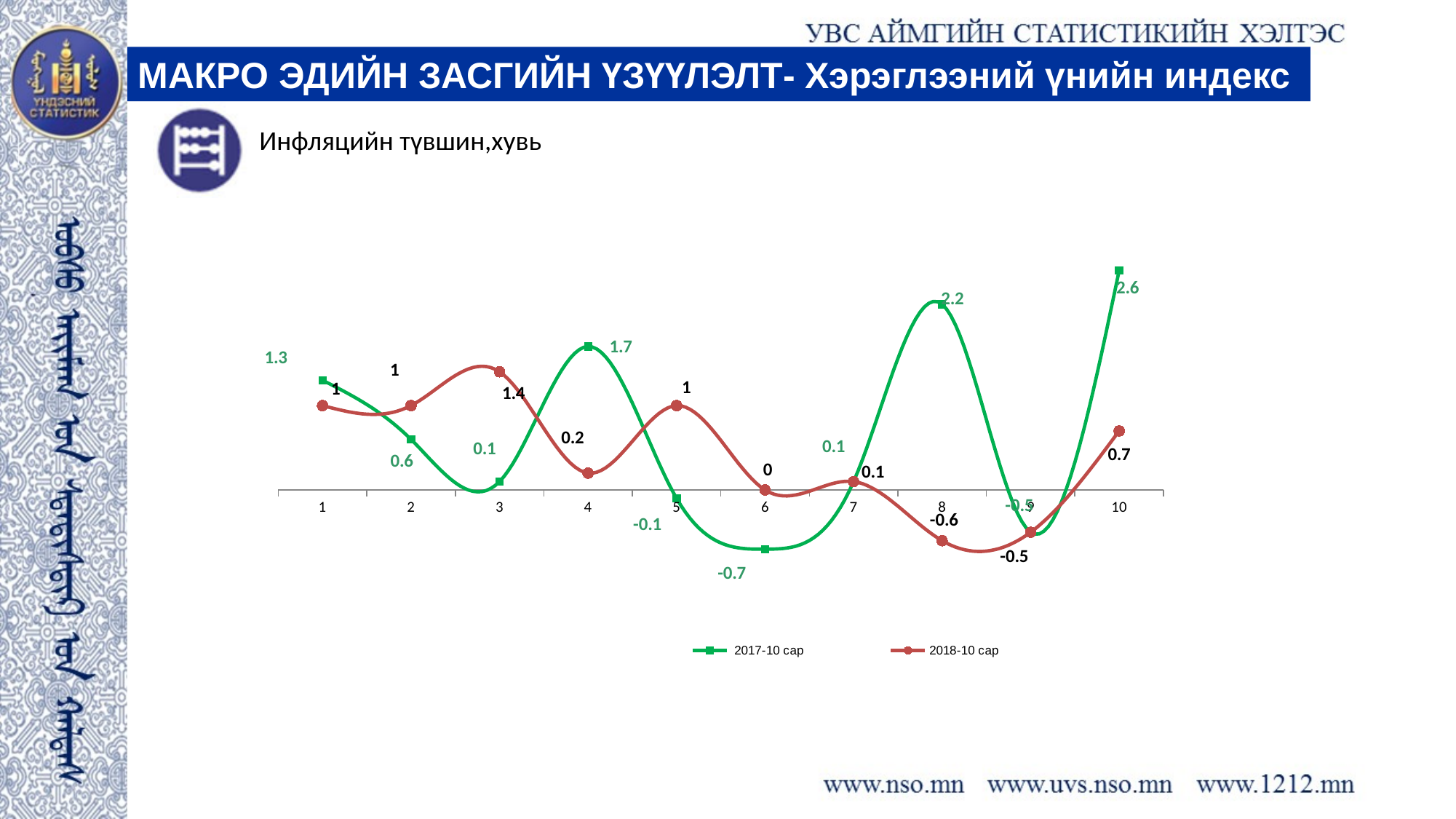
How many series does the legend list? 2 What is the title shown above the chart? Инфляцийн түвшин,хувь At which x-axis point does the 2017-10 сар series reach its highest value? 10 At point 8, which series has the larger value, 2017-10 сар or 2018-10 сар? 2017-10 сар At which x-axis point does the 2017-10 сар series reach its lowest value? 6 How many points are plotted along the x axis for each series? 10 What is the value of the 2018-10 сар series at point 3? 1.4 What kind of chart is shown on the slide? line chart At which x-axis point does the 2018-10 сар series reach its highest value? 3 What is the value of the 2017-10 сар series at point 10? 2.6 What is the value of the 2017-10 сар series at point 6? -0.7 What is the difference between the 2017-10 сар and 2018-10 сар values at point 4? 1.5